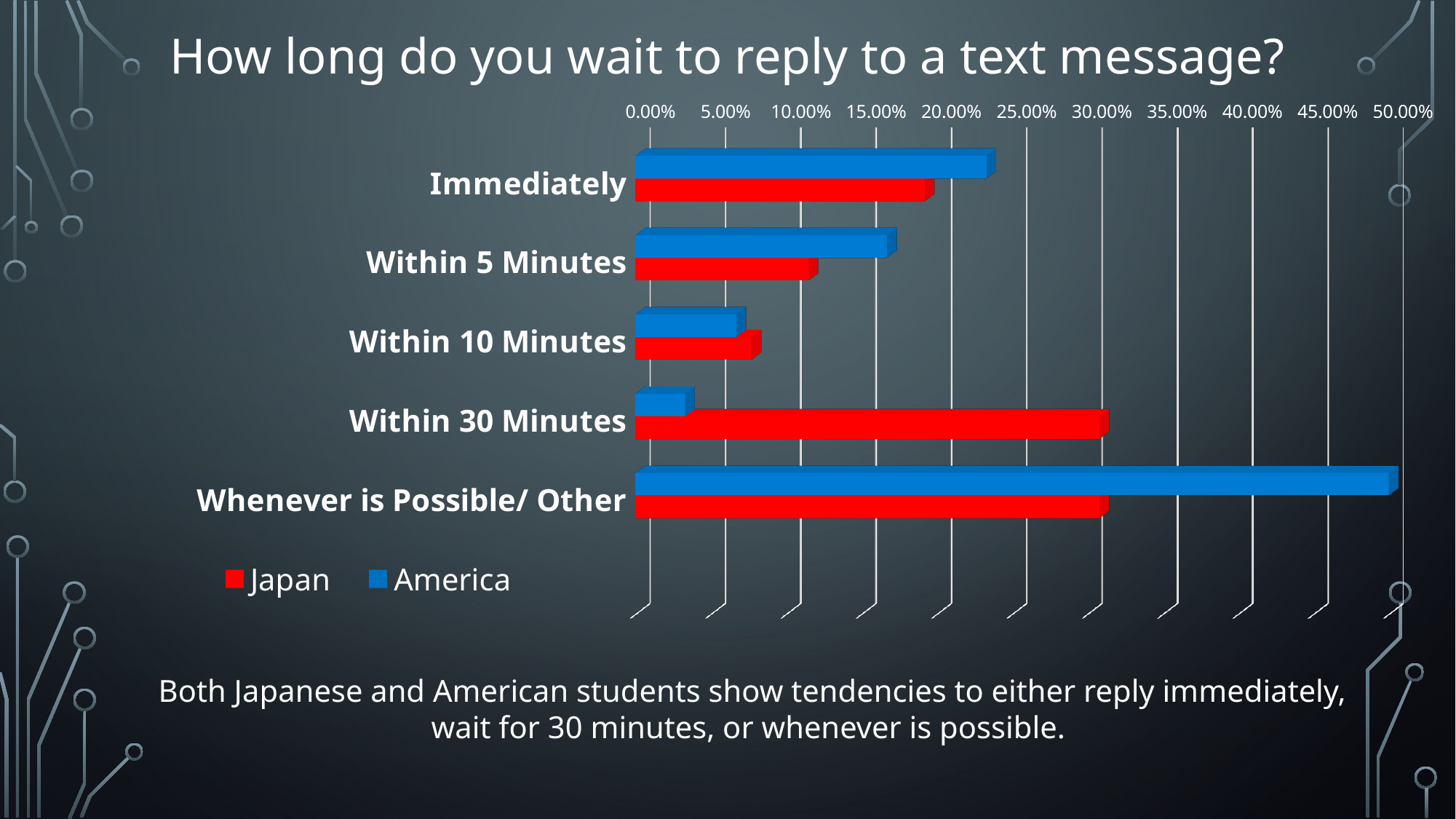
What kind of chart is shown on the slide? Bar chart What is the title of the chart? How long do you wait to reply to a text message? Which category has the lowest value for America? Within 30 Minutes How many response categories are plotted on the chart? 5 Is the value for America in 'Whenever is Possible/ Other' greater or less than 45.00%? greater Is the value for America in 'Within 30 Minutes' greater or less than 5.00%? less For 'Immediately', which series has the larger value, Japan or America? America For 'Within 30 Minutes', which series has the larger value, Japan or America? Japan How many series does the legend list? 2 Which category has the highest value for America? Whenever is Possible/ Other Is the value for Japan in 'Immediately' greater or less than 20.00%? less Which colour represents Japan in the chart? Red